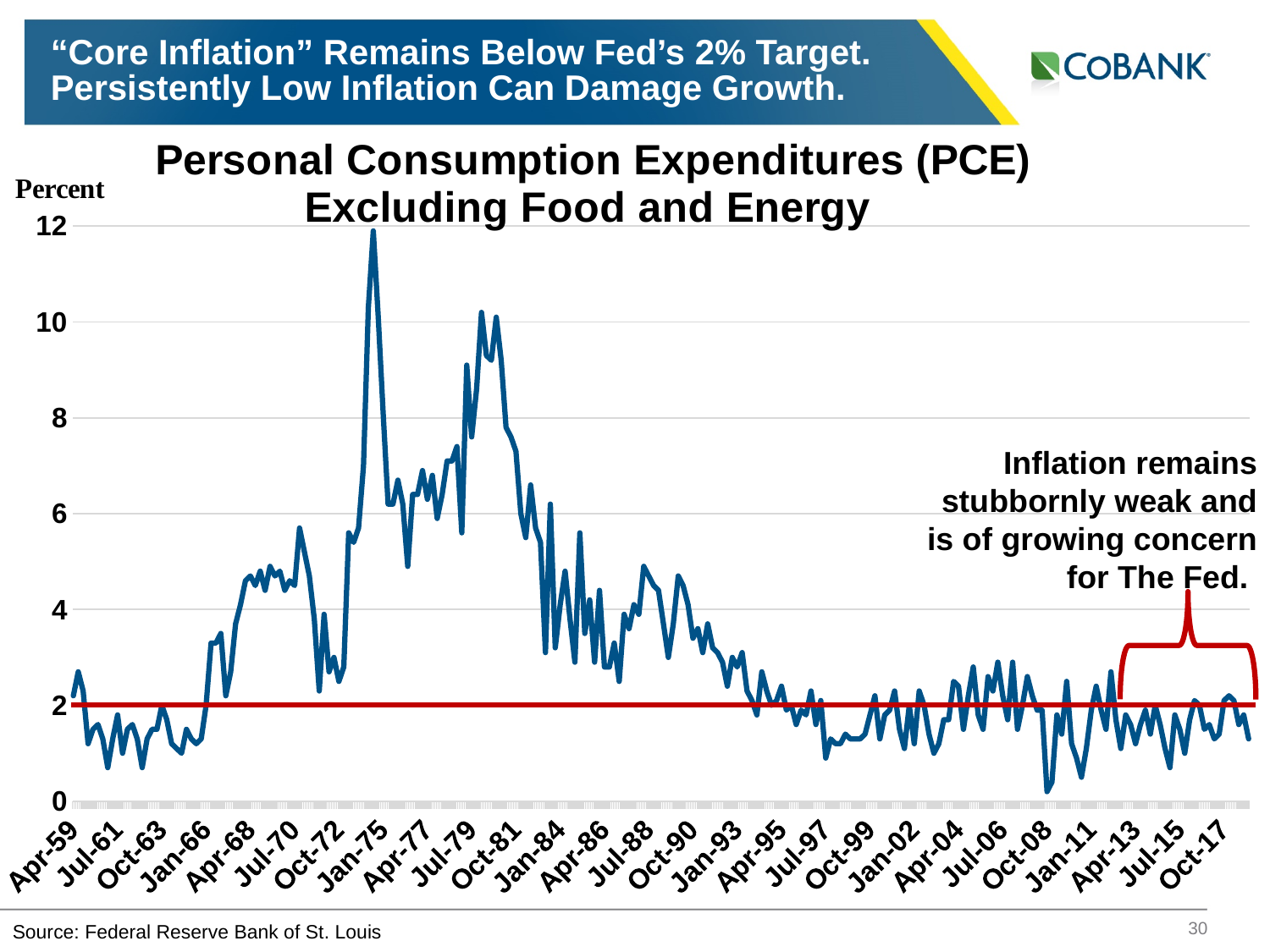
How many labels are shown on the x axis of the chart? 27 What kind of chart is shown on the slide? Line chart Is the value of the line at Jul-97 greater or less than 4? less Is the peak value of the line near Jan-75 greater or less than 10? greater Does the line generally rise or fall between Oct-63 and Jul-70? rise Around which x-axis label does the line reach its highest value? Jan-75 What is the title of the chart? Personal Consumption Expenditures (PCE) Excluding Food and Energy Is the value of the line at Jul-79 greater or less than 6? greater What unit is shown on the vertical axis of the chart? Percent Does the line generally rise or fall between Jul-79 and Jul-97? fall